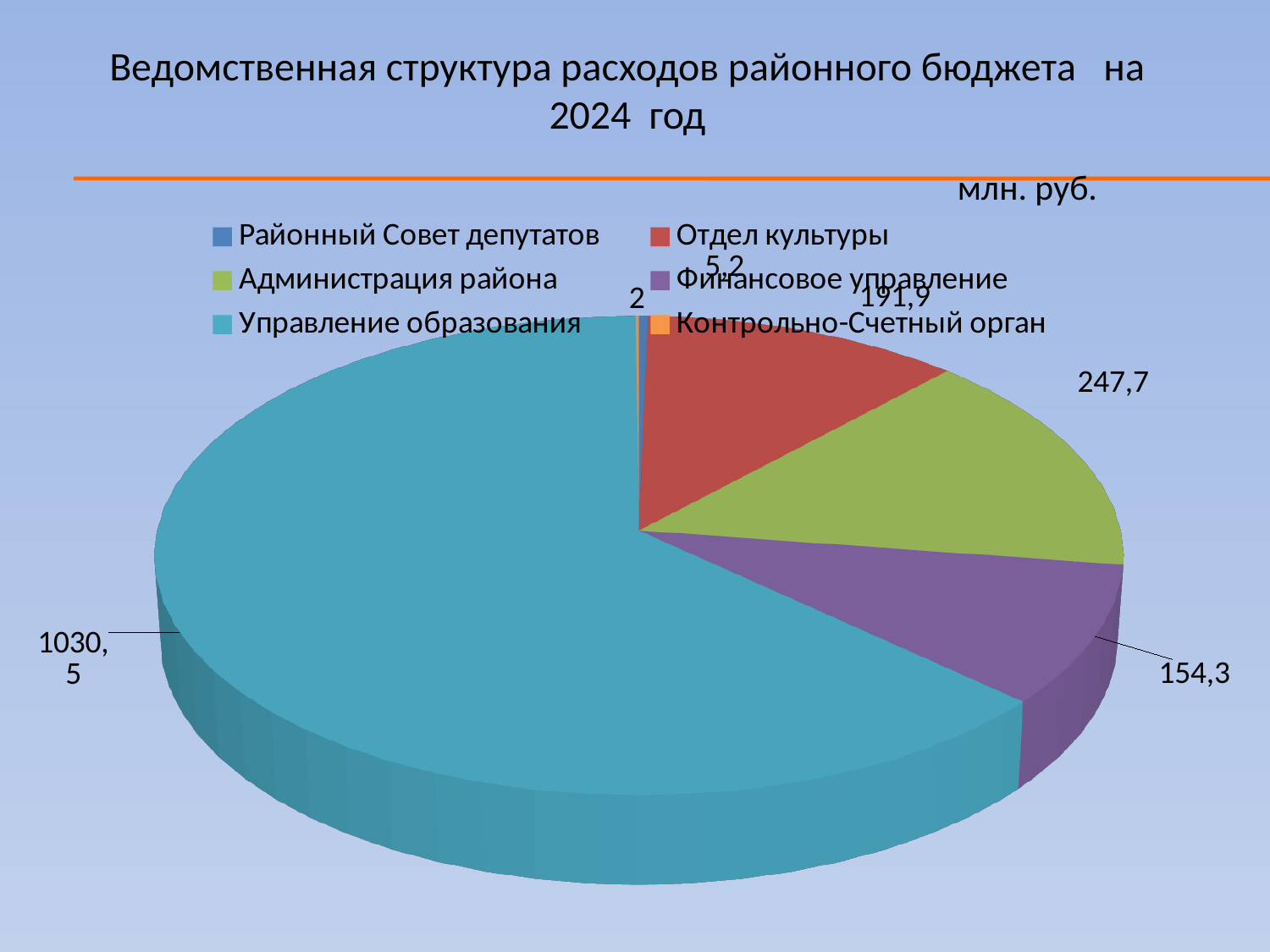
Which category has the largest slice of the pie? Управление образования How many categories does the legend list? 6 What is the value for Отдел культуры? 191,9 What is the difference between Администрация района and Отдел культуры? 55,8 What is the value for Управление образования? 1030,5 What is the value for Финансовое управление? 154,3 What is the value for Администрация района? 247,7 What type of chart is shown on the slide? Pie chart What is the difference between Отдел культуры and Финансовое управление? 37,6 Which is larger, Администрация района or Отдел культуры? Администрация района Which category has the smallest slice of the pie? Контрольно-Счетный орган What unit is indicated for the values on the chart? млн. руб.